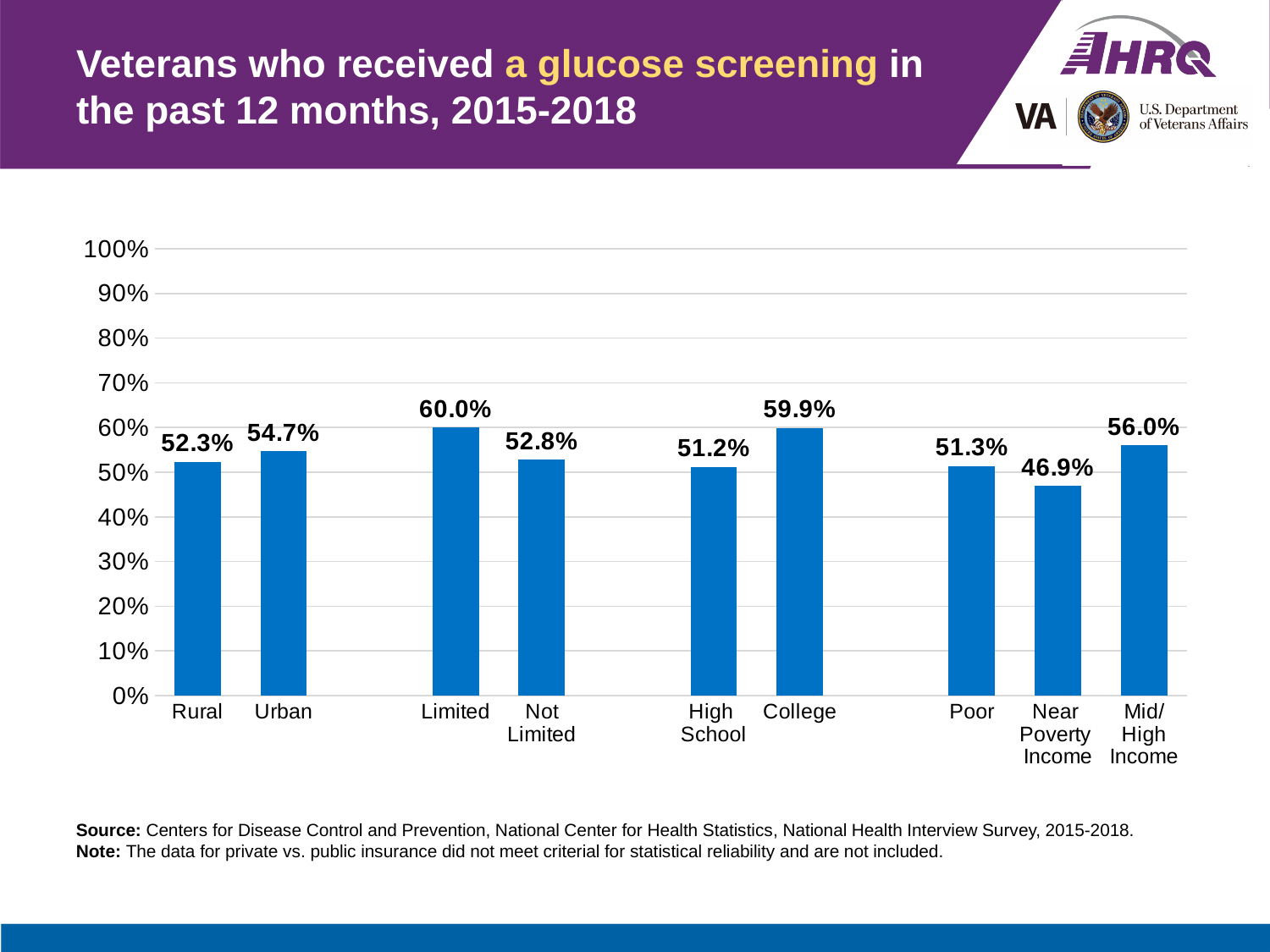
What is the value shown for the College group? 59.9% What is the difference in percentage points between the Limited and Not Limited groups? 7.2 Which group has a higher value, Poor or Mid/High Income? Mid/High Income How many categories are shown on the chart? 9 What is the difference in percentage points between Urban and Rural veterans? 2.4 What is the highest value shown on the vertical axis? 100% What percentage of Rural veterans received a glucose screening in the past 12 months? 52.3% What is the value shown for the Near Poverty Income group? 46.9% Which category has the lowest percentage of veterans receiving a glucose screening? Near Poverty Income Which category has the highest percentage of veterans receiving a glucose screening? Limited Which group has a higher value, High School or College? College What type of chart is shown on the slide? Bar chart